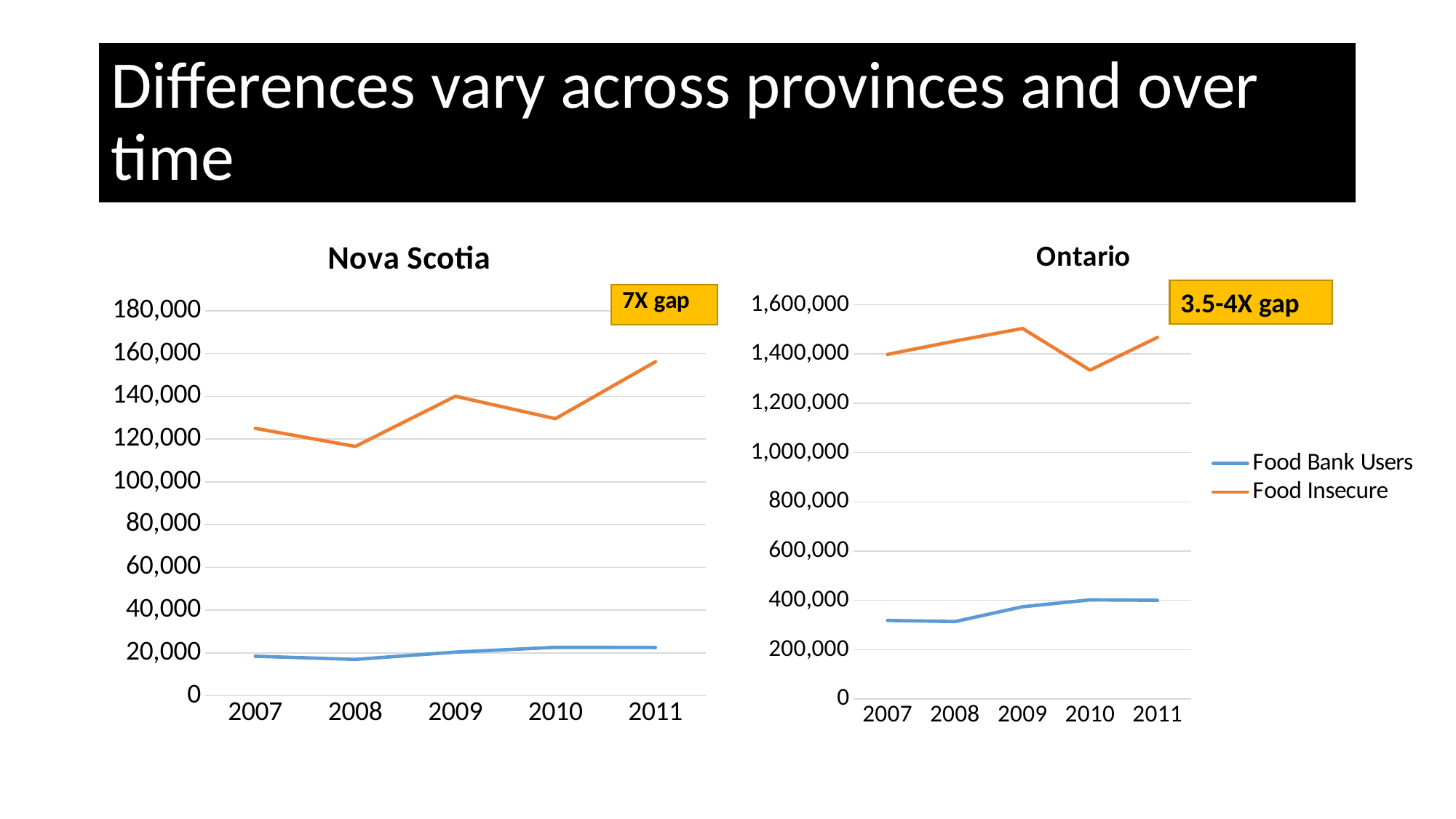
How many years are plotted on the x axis of the Ontario chart? 5 In the Nova Scotia chart, is the Food Bank Users value for 2011 greater or less than 40,000? less In the Ontario chart, is the Food Insecure value for 2010 greater or less than 1,400,000? less In the Nova Scotia chart, in which year is the orange Food Insecure line lowest? 2008 How many series does the legend on the slide list? 2 In the Ontario chart, in which year is the Food Insecure line highest? 2009 In the Nova Scotia chart, is the Food Insecure value for 2011 greater or less than 140,000? greater In the Nova Scotia chart, in which year is the orange Food Insecure line highest? 2011 What does the yellow annotation box on the Nova Scotia chart say? 7X gap In the Ontario chart, which series has the larger value in 2011, Food Bank Users or Food Insecure? Food Insecure In the Ontario chart, in which year is the Food Insecure line lowest? 2010 What kind of chart is the Nova Scotia chart? line chart